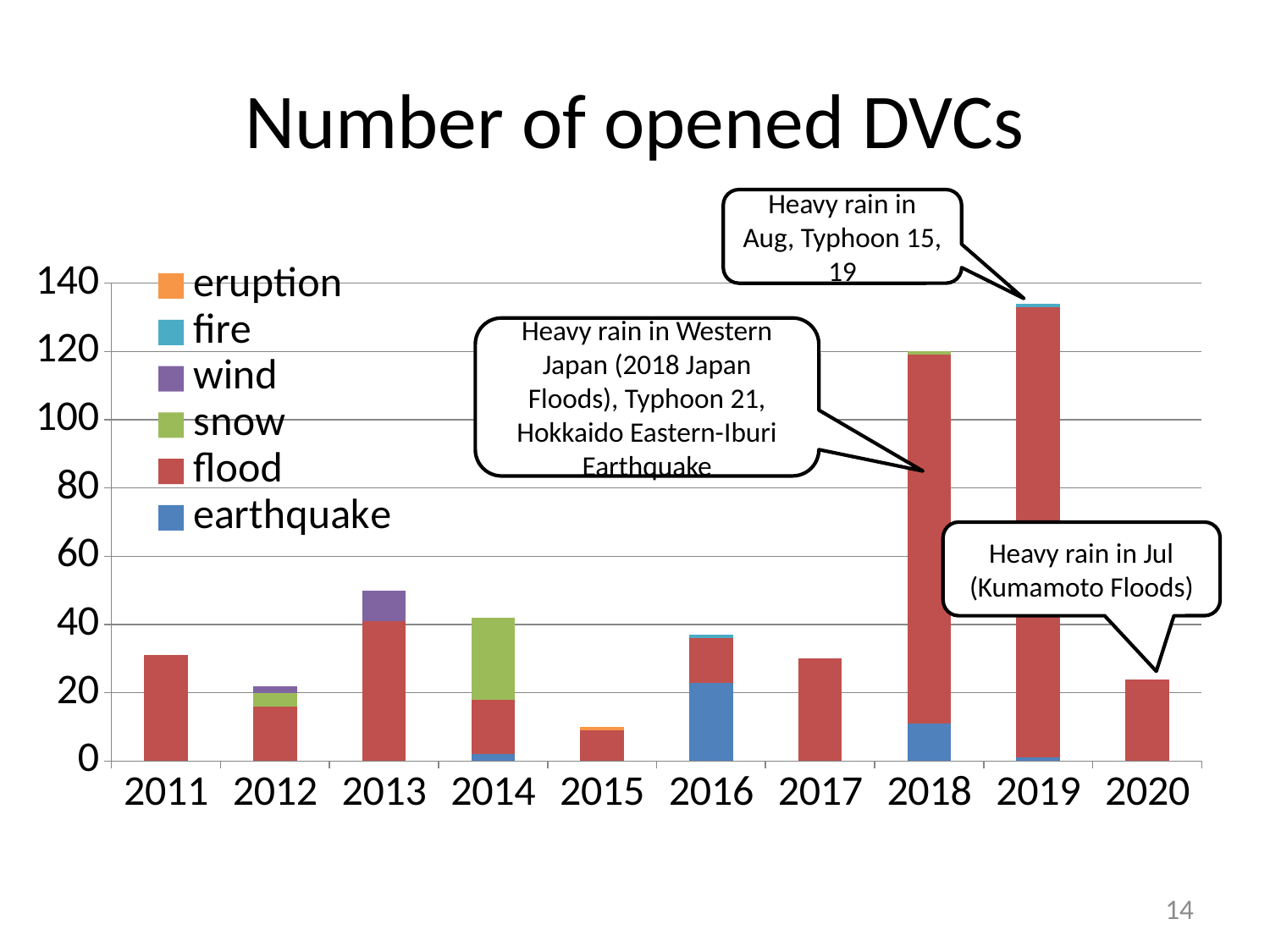
How many years are shown on the x axis of the chart? 10 Which year has the lowest total number of opened DVCs? 2015 Is the total value for 2019 greater or less than 120? greater Which year has a larger total, 2017 or 2018? 2018 Which year has the highest total number of opened DVCs? 2019 Is the total value for 2015 greater or less than 20? less What kind of chart is shown on the slide? stacked bar chart What is the title of the chart? Number of opened DVCs Is the total value for 2011 greater or less than 40? less How many series does the legend list? 6 Which year has a larger total, 2012 or 2013? 2013